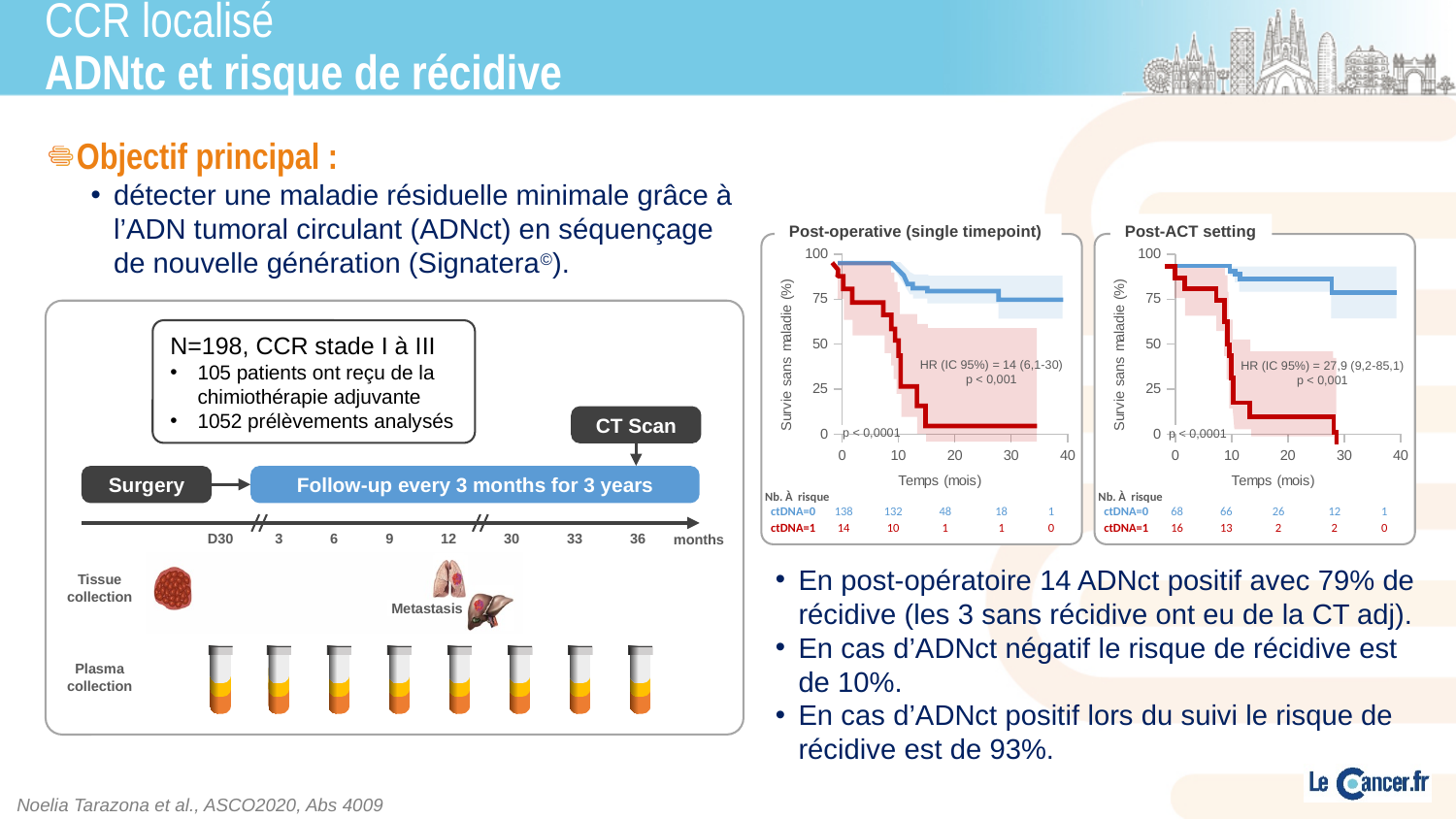
In the 'Post-ACT setting' chart, how many patients with ctDNA=1 are at risk at 0 months? 16 In the 'Post-operative (single timepoint)' chart, what is the hazard ratio (HR) printed on the chart? 14 (6,1-30) In the 'Post-ACT setting' chart, which group has the higher disease-free survival at 20 months, ctDNA=0 or ctDNA=1? ctDNA=0 In the 'Post-operative (single timepoint)' chart, how many patients with ctDNA=0 are at risk at 0 months? 138 In the 'Post-operative (single timepoint)' chart, how many patients with ctDNA=1 are at risk at 10 months? 10 In the 'Post-operative (single timepoint)' chart, is the disease-free survival of the ctDNA=1 group at 20 months greater or less than 25%? less In the 'Post-ACT setting' chart, how many patients with ctDNA=0 are at risk at 20 months? 26 In the 'Post-operative (single timepoint)' chart, what is the difference between the number of ctDNA=0 and ctDNA=1 patients at risk at 0 months? 124 In the 'Post-ACT setting' chart, is the disease-free survival of the ctDNA=0 group at 30 months greater or less than 50%? greater What kind of chart is the 'Post-operative (single timepoint)' chart? line chart (survival curve) What is the label of the x axis in the 'Post-operative (single timepoint)' chart? Temps (mois) In the 'Post-ACT setting' chart, what is the hazard ratio (HR) printed on the chart? 27,9 (9,2-85,1)